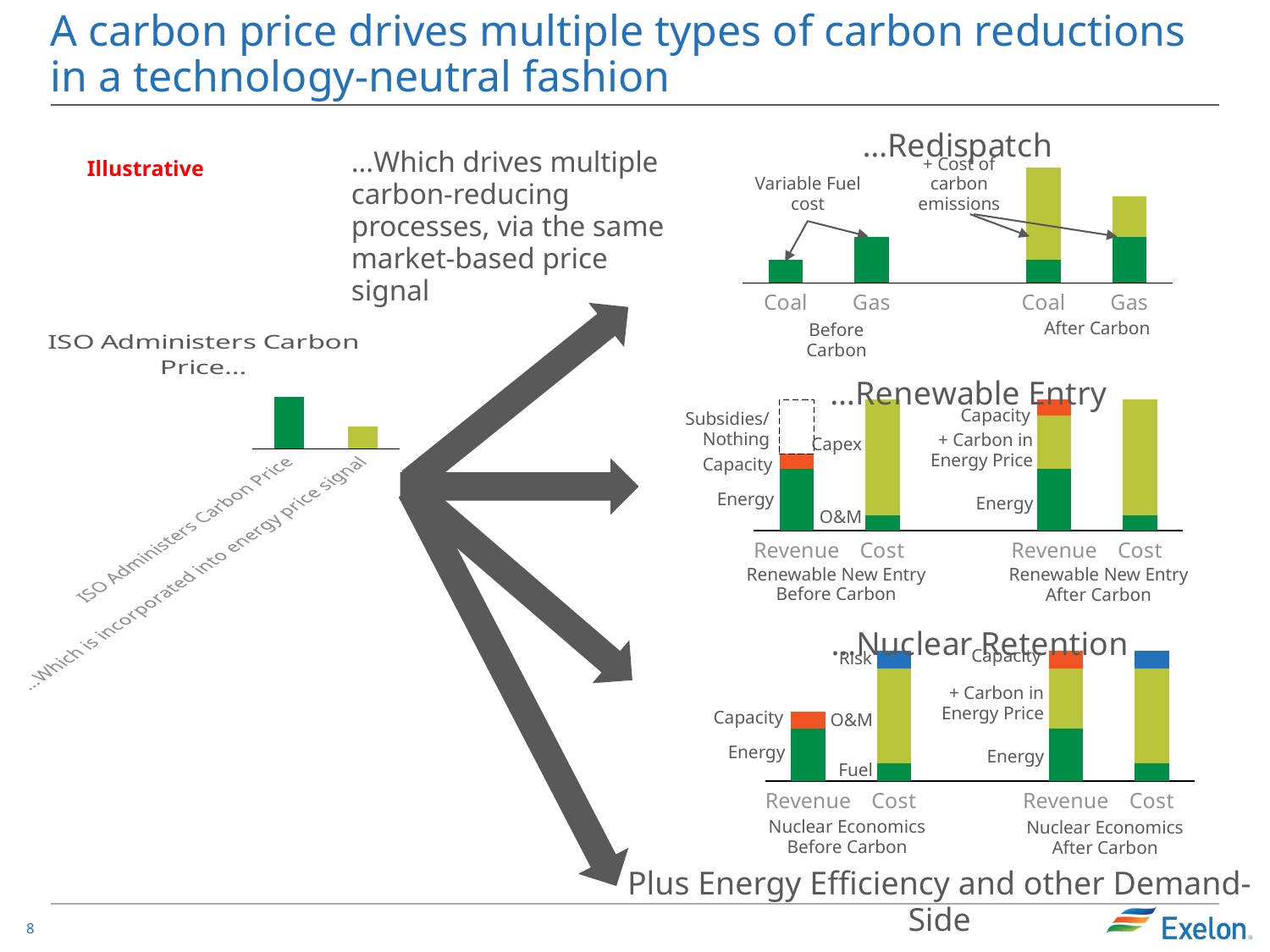
In the "...Renewable Entry" chart, what segment is added to the Revenue bar after carbon? + Carbon in Energy Price In the "...Redispatch" chart, what does the light green segment added to the After Carbon bars represent? + Cost of carbon emissions In the "...Redispatch" chart, before carbon, which bar is taller, Coal or Gas? Gas In the "...Nuclear Retention" chart, what are the three segments that make up the Cost bar? Fuel, O&M, Risk In the "...Nuclear Retention" chart, before carbon, which bar is taller, Revenue or Cost? Cost In the "ISO Administers Carbon Price..." chart on the left, which bar is taller, the first (green) bar or the second (light green) bar? the first (green) bar In the "...Redispatch" chart, what does the dark green segment of the Before Carbon bars represent? Variable Fuel cost In the "ISO Administers Carbon Price..." chart on the left, how many bars are plotted? 2 What kind of chart is the "...Redispatch" chart at the top right of the slide? bar chart In the "...Renewable Entry" chart, what are the two segments that make up the Cost bar? O&M, Capex In the "...Redispatch" chart, how many bars are plotted in total? 4